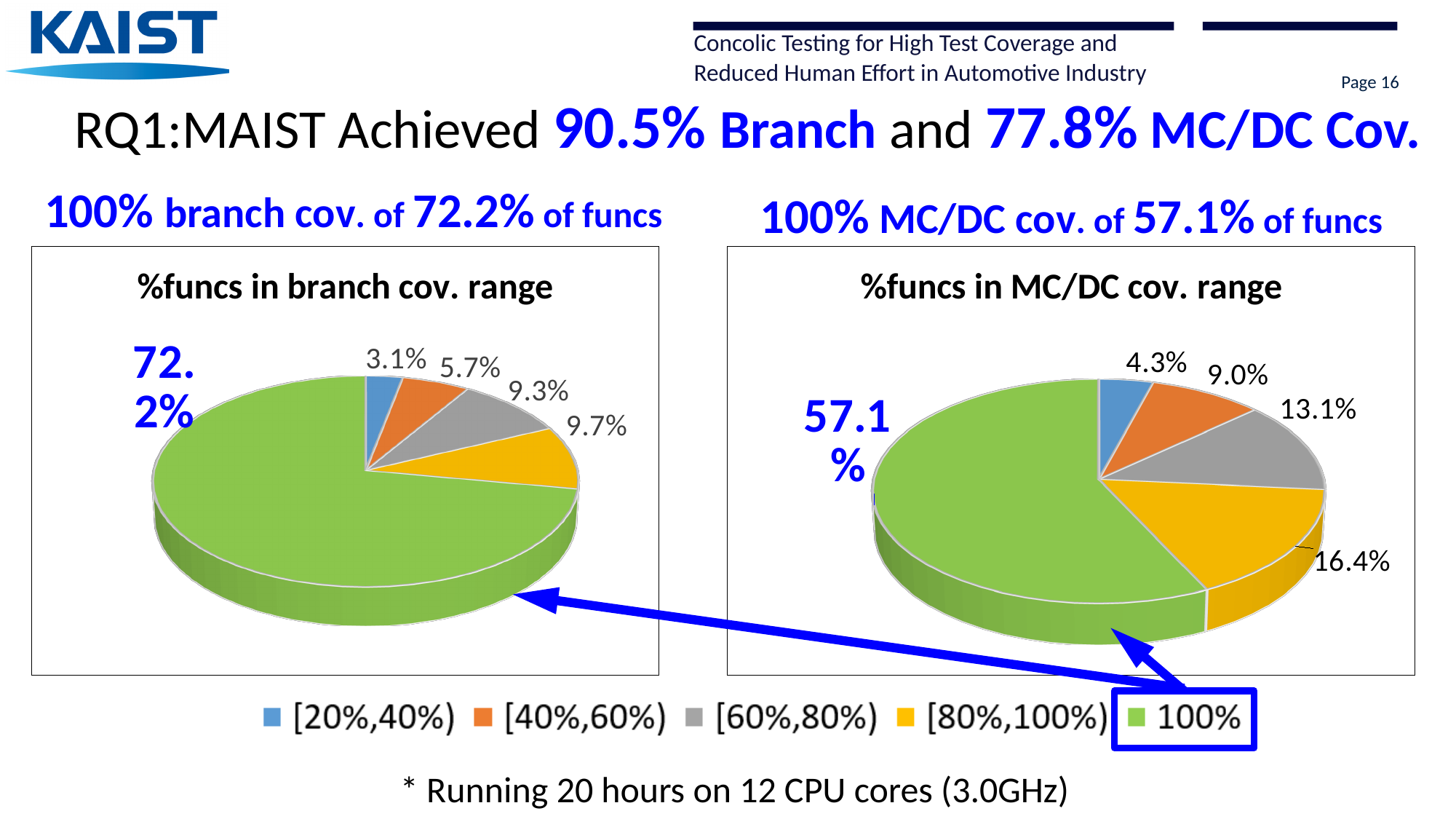
What colour represents the 100% category in the legend? Green What type of chart is the '%funcs in MC/DC cov. range' chart? Pie chart In the '%funcs in MC/DC cov. range' chart, which is larger: the [40%,60%) slice or the [60%,80%) slice? [60%,80%) In the '%funcs in MC/DC cov. range' chart, what percentage of functions fall in the [80%,100%) range? 16.4% In the '%funcs in MC/DC cov. range' chart, what percentage of functions fall in the [20%,40%) range? 4.3% How many slices does the '%funcs in branch cov. range' chart have? 5 What is the difference between the 100% slice in the '%funcs in branch cov. range' chart and the 100% slice in the '%funcs in MC/DC cov. range' chart? 15.1% In the '%funcs in branch cov. range' chart, what percentage of functions fall in the 100% category? 72.2% How many entries does the shared legend list? 5 In the '%funcs in MC/DC cov. range' chart, which category has the largest slice? 100% In the '%funcs in branch cov. range' chart, what percentage of functions fall in the [60%,80%) range? 9.3% In the '%funcs in branch cov. range' chart, which category has the smallest slice? [20%,40%)